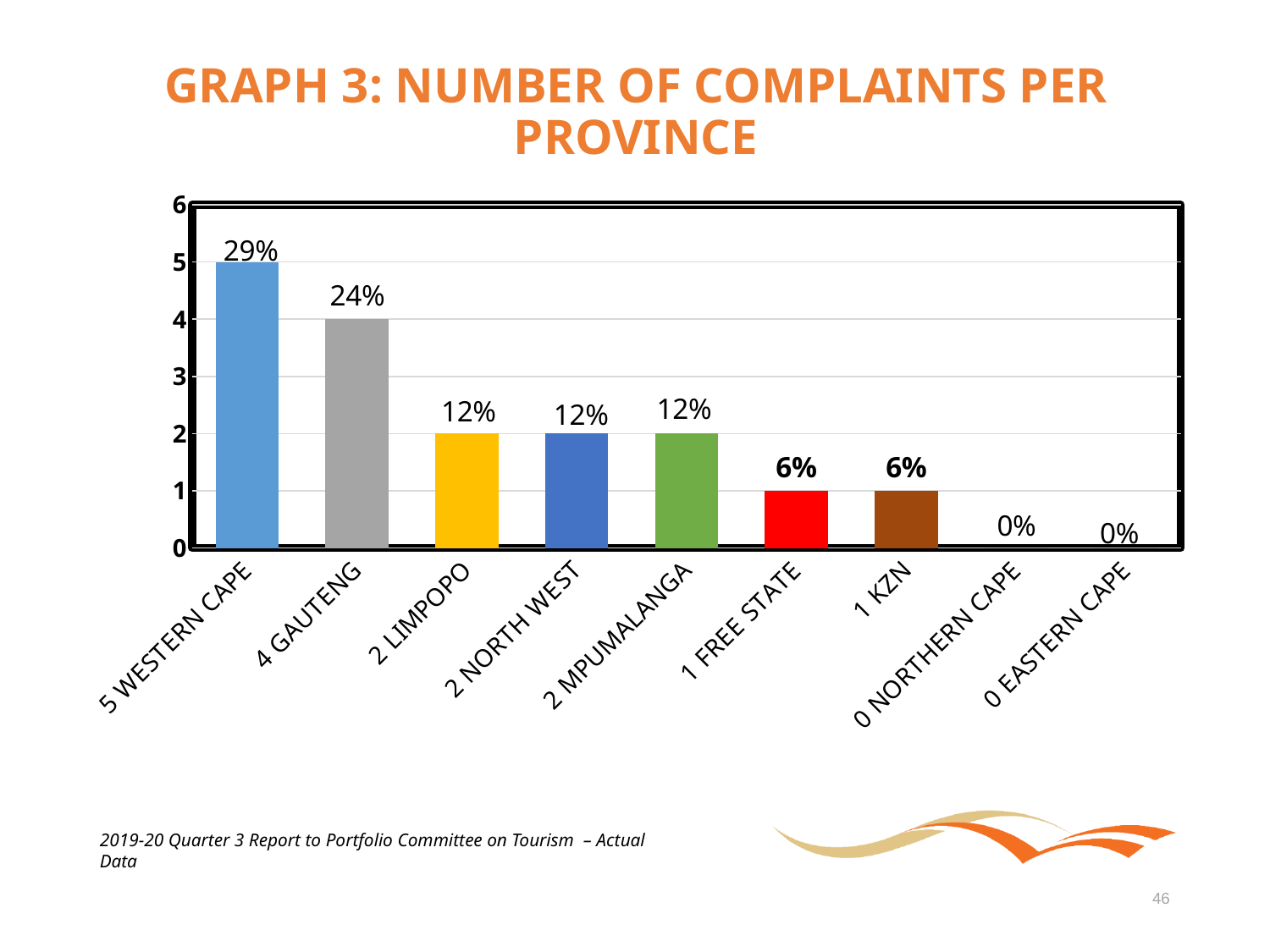
How many complaints does the bar for 2 LIMPOPO reach on the vertical axis? 2 How many provinces are shown on the x axis? 9 Which province has the highest number of complaints? 5 WESTERN CAPE What kind of chart is shown on the slide? bar chart What is the difference in percentage points between the labels for 5 WESTERN CAPE and 4 GAUTENG? 5% What percentage label is shown above the bar for 5 WESTERN CAPE? 29% What is the title of the chart? GRAPH 3: NUMBER OF COMPLAINTS PER PROVINCE Do the values rise or fall moving from left to right along the x axis? fall Which has a larger value, 4 GAUTENG or 2 NORTH WEST? 4 GAUTENG What percentage label is shown above the bar for 4 GAUTENG? 24% Is the value for 5 WESTERN CAPE greater or less than 4? greater What percentage label is shown for 1 FREE STATE? 6%